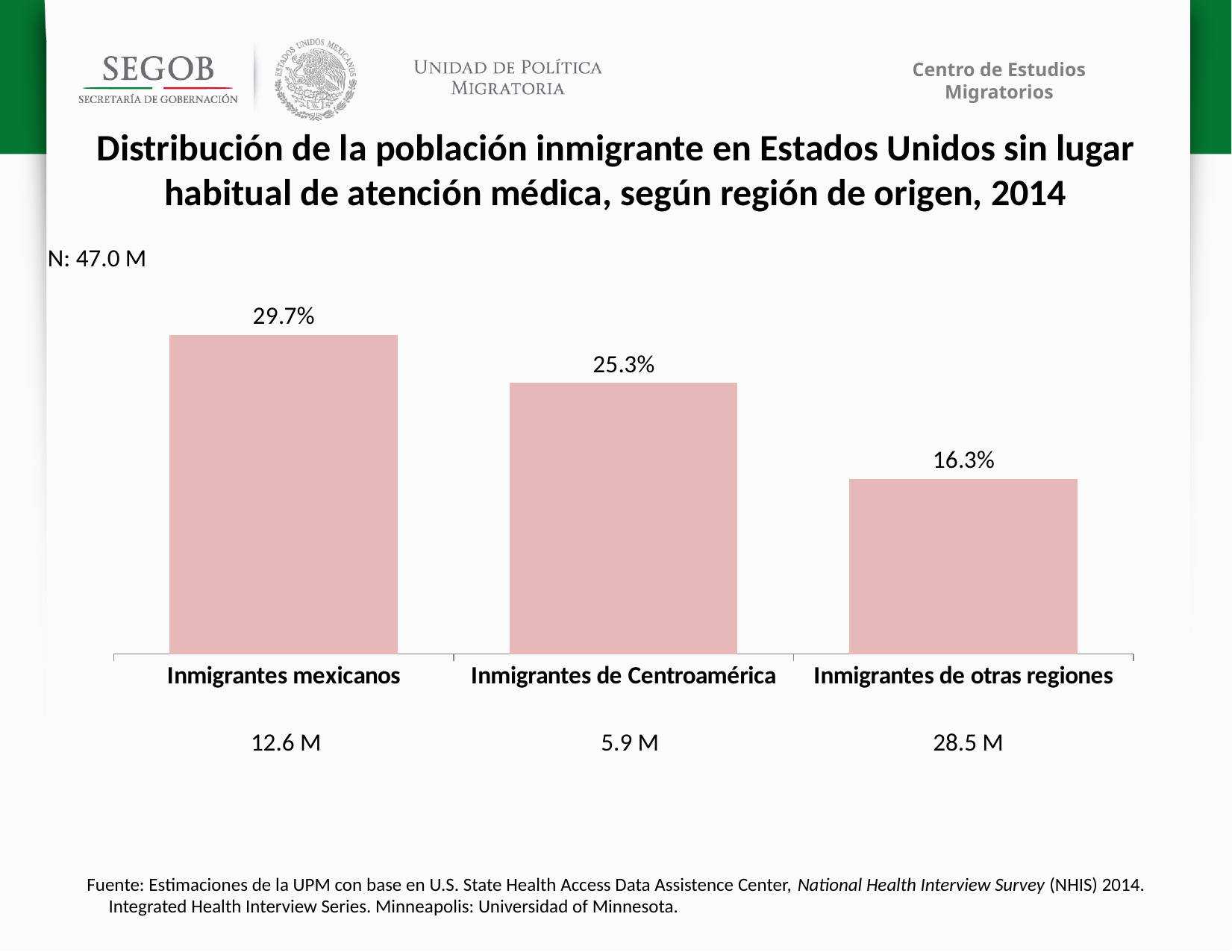
What is the difference between the values for Inmigrantes mexicanos and Inmigrantes de Centroamérica? 4.4% Which is larger, the value for Inmigrantes de Centroamérica or for Inmigrantes de otras regiones? Inmigrantes de Centroamérica What is the value for Inmigrantes de Centroamérica? 25.3% How many categories are shown in the chart? 3 What is the value for Inmigrantes mexicanos? 29.7% Which category has the highest value? Inmigrantes mexicanos Do the values rise or fall from left to right along the x axis? Fall Which category has the lowest value? Inmigrantes de otras regiones What population size (in millions) is shown below the Inmigrantes de otras regiones bar? 28.5 M What is the value for Inmigrantes de otras regiones? 16.3% What kind of chart is shown on the slide? Bar chart What is the difference between the values for Inmigrantes mexicanos and Inmigrantes de otras regiones? 13.4%